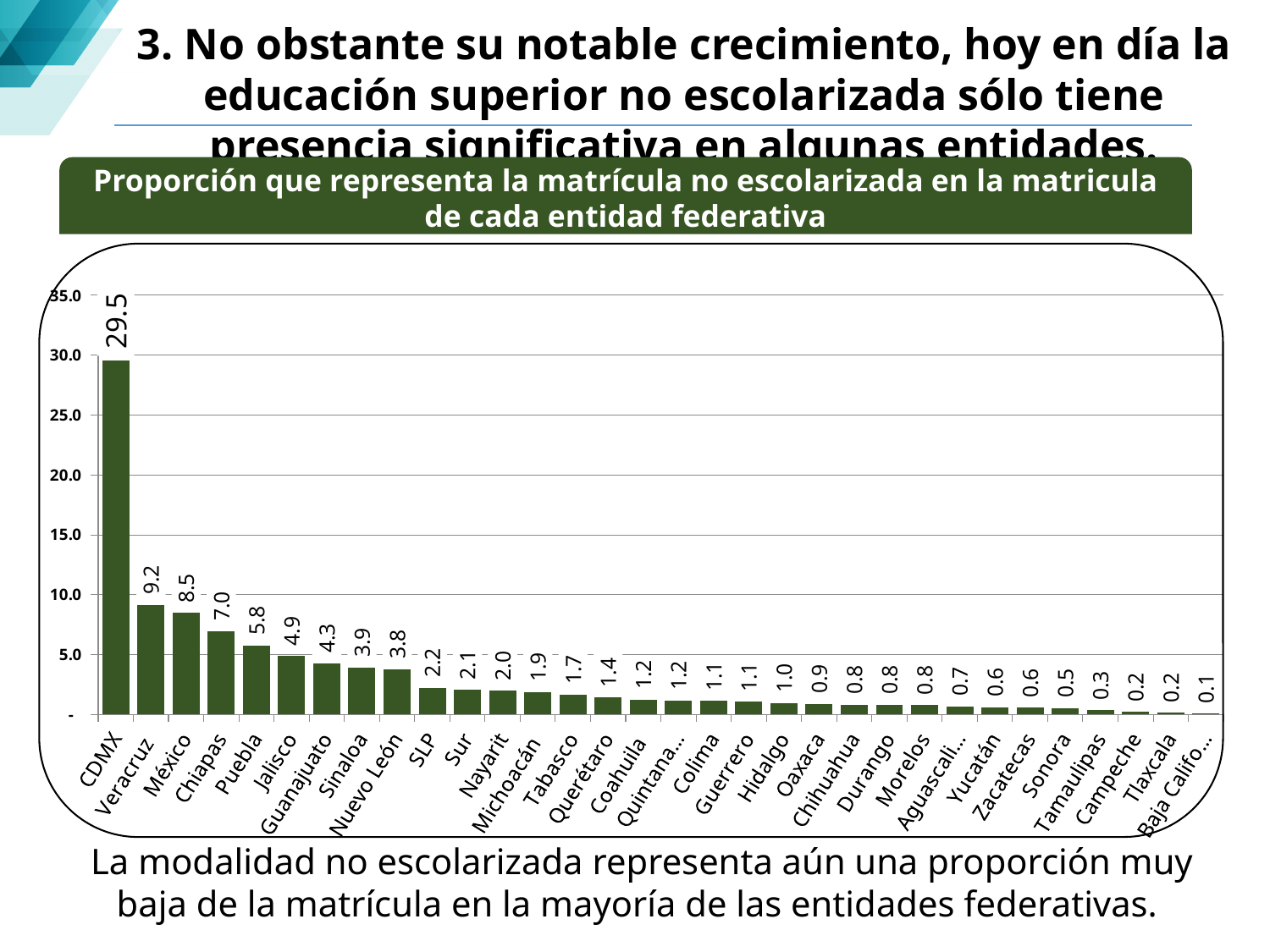
How many entities (bars) are shown on the chart? 32 What is the value for Veracruz? 9.2 What is the value for Jalisco? 4.9 What is the value for Oaxaca? 0.9 Which entity has the highest value? CDMX What is the difference between the values for CDMX and Veracruz? 20.3 What is the value for CDMX? 29.5 What is the smallest value shown on the chart? 0.1 What is the value for Nuevo León? 3.8 Which is larger, the value for Chiapas or the value for Puebla? Chiapas What is the difference between the values for México and Chiapas? 1.5 What kind of chart is shown on the slide? Bar chart